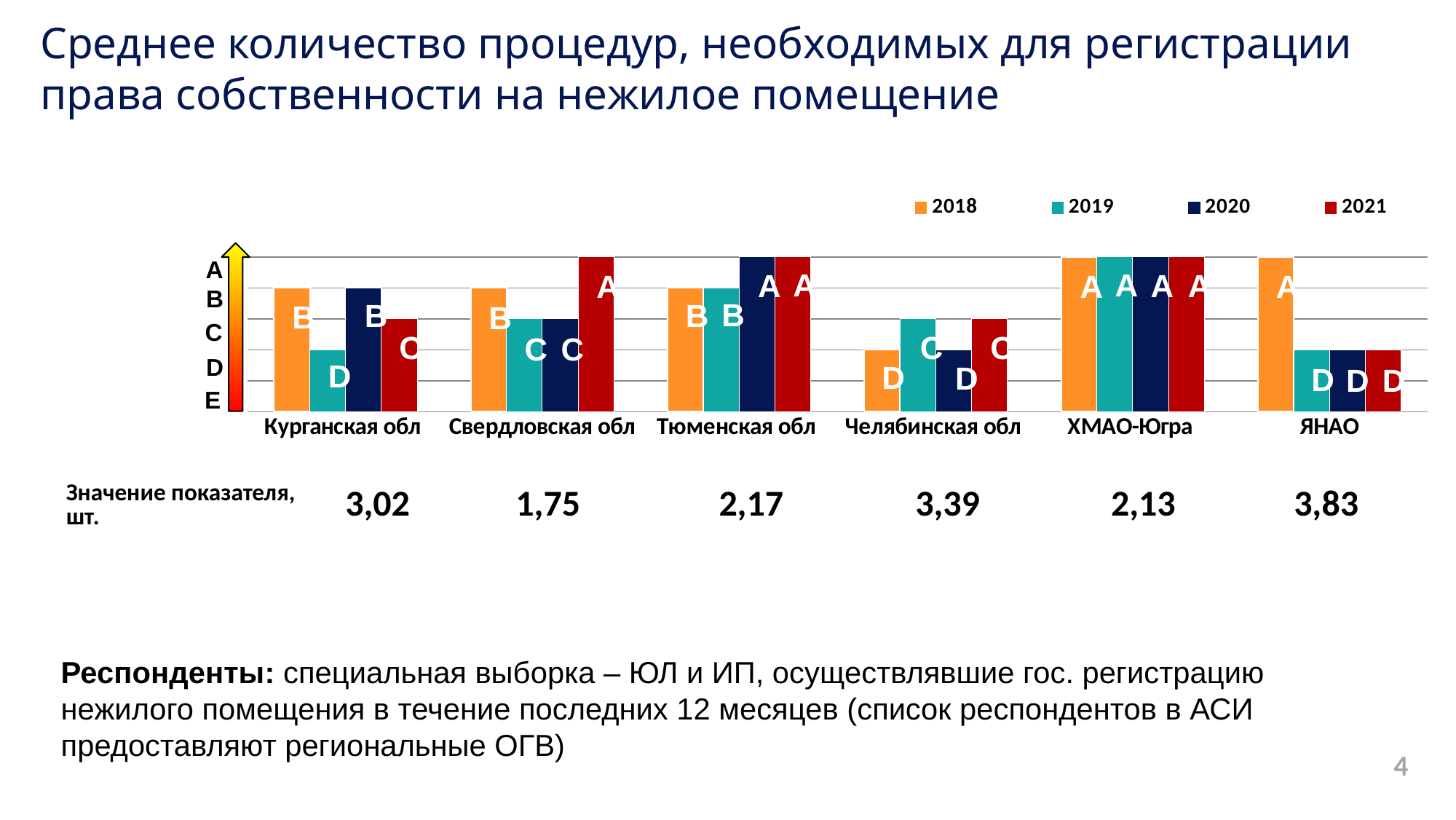
What is the value of the indicator (Значение показателя, шт.) for Тюменская обл? 2,17 How many series does the legend list? 4 Which region has the larger indicator value, Курганская обл or ХМАО-Югра? Курганская обл How many regions are shown along the x axis of the chart? 6 What grade is shown for Челябинская обл in 2018? D What grade is shown for Курганская обл in 2019? D Which year is represented by the orange bars in the legend? 2018 What grade is shown for Свердловская обл in 2021? A Which region has the highest value of the indicator (Значение показателя, шт.)? ЯНАО Which region has the lowest value of the indicator (Значение показателя, шт.)? Свердловская обл What kind of chart is shown on the slide? bar chart What grade is shown for ЯНАО in 2018? A